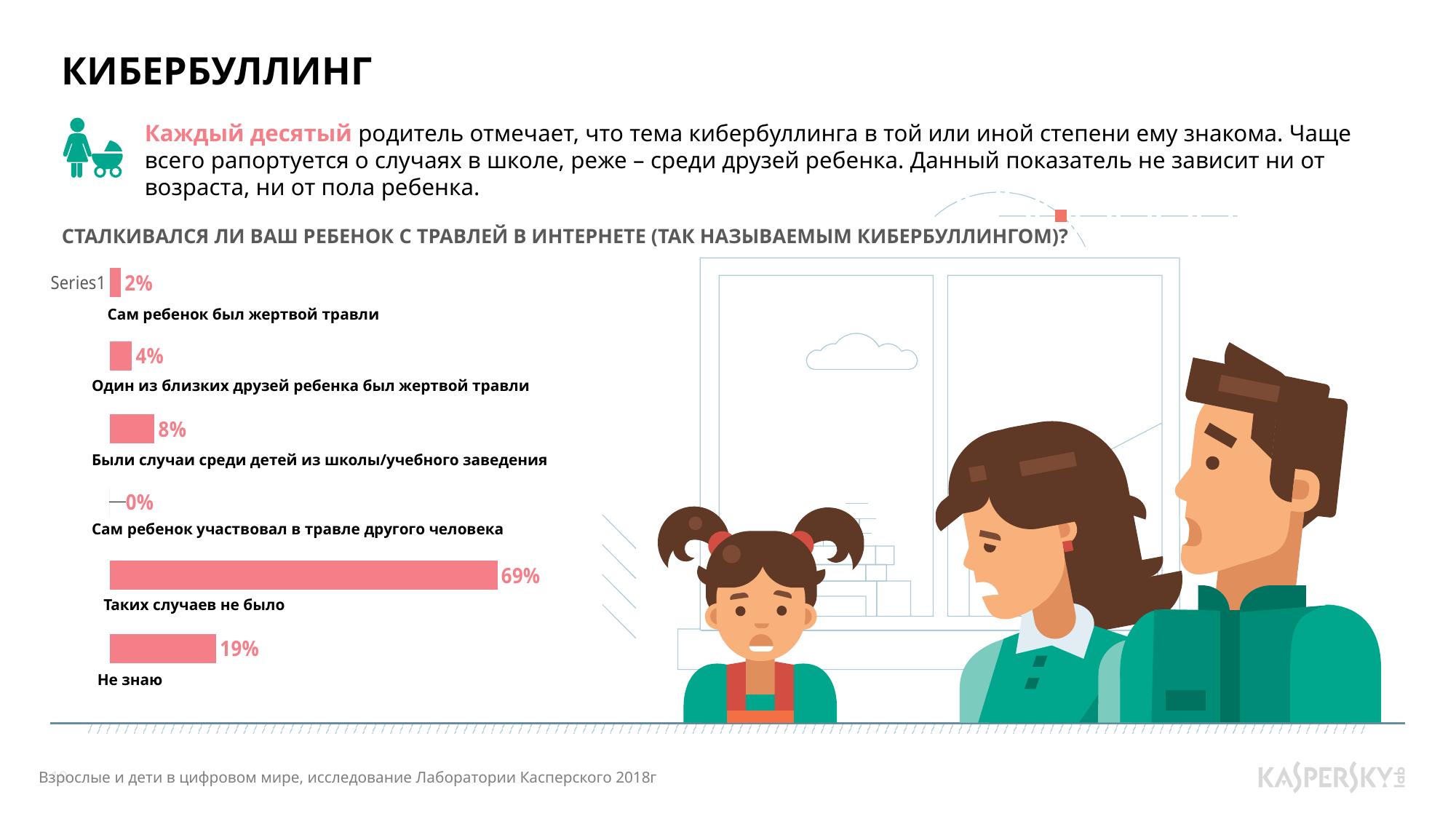
How many answer options are shown in the chart? 6 What percentage is shown for "Были случаи среди детей из школы/учебного заведения"? 8% Which is larger: "Один из близких друзей ребенка был жертвой травли" or "Сам ребенок был жертвой травли"? Один из близких друзей ребенка был жертвой травли What is the difference between "Таких случаев не было" and "Не знаю"? 50% What percentage of parents answered "Таких случаев не было"? 69% What is the value for "Не знаю"? 19% What is the value for "Сам ребенок был жертвой травли"? 2% What percentage is shown for "Сам ребенок участвовал в травле другого человека"? 0% Which answer option has the highest value? Таких случаев не было Which answer option has the lowest value? Сам ребенок участвовал в травле другого человека What is the difference between "Были случаи среди детей из школы/учебного заведения" and "Один из близких друзей ребенка был жертвой травли"? 4% What type of chart is used on the slide? Bar chart